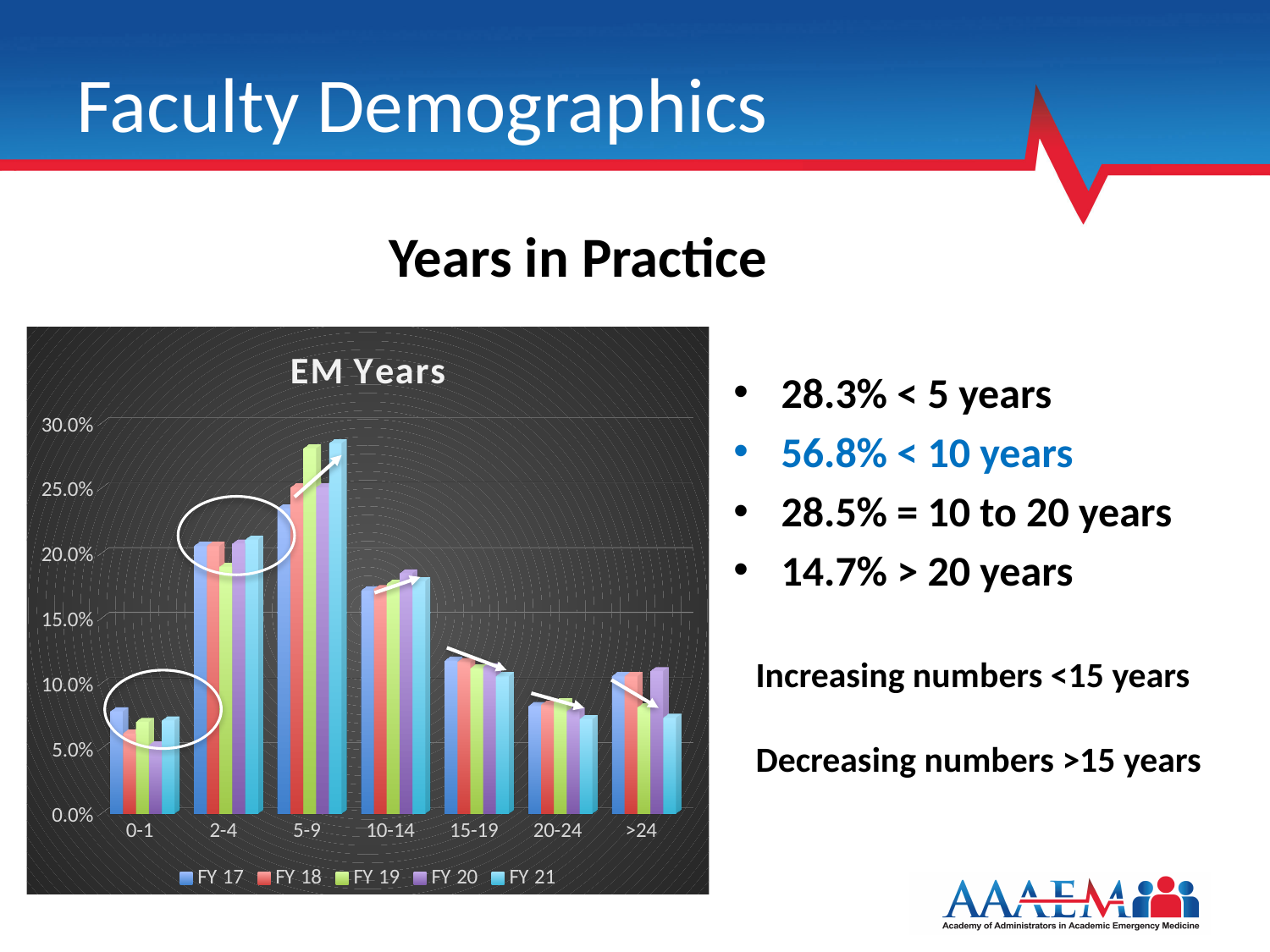
Is the FY 21 value for the 5-9 category greater or less than 25.0%? greater In the EM Years chart, do the FY 21 values rise or fall moving from the 5-9 category to the >24 category? fall Is the FY 17 value for the 0-1 category greater or less than 5.0%? greater What kind of chart is the EM Years chart? bar chart How many series does the legend of the EM Years chart list? 5 What is the title of the chart on the slide? EM Years Which series is listed last in the legend of the EM Years chart? FY 21 Is the FY 21 value for the 20-24 category greater or less than 10.0%? less How many categories are shown on the x axis of the EM Years chart? 7 Which is larger in the EM Years chart: the FY 21 value for 5-9 or the FY 21 value for 0-1? FY 21 value for 5-9 Which category on the x axis of the EM Years chart has the highest bars? 5-9